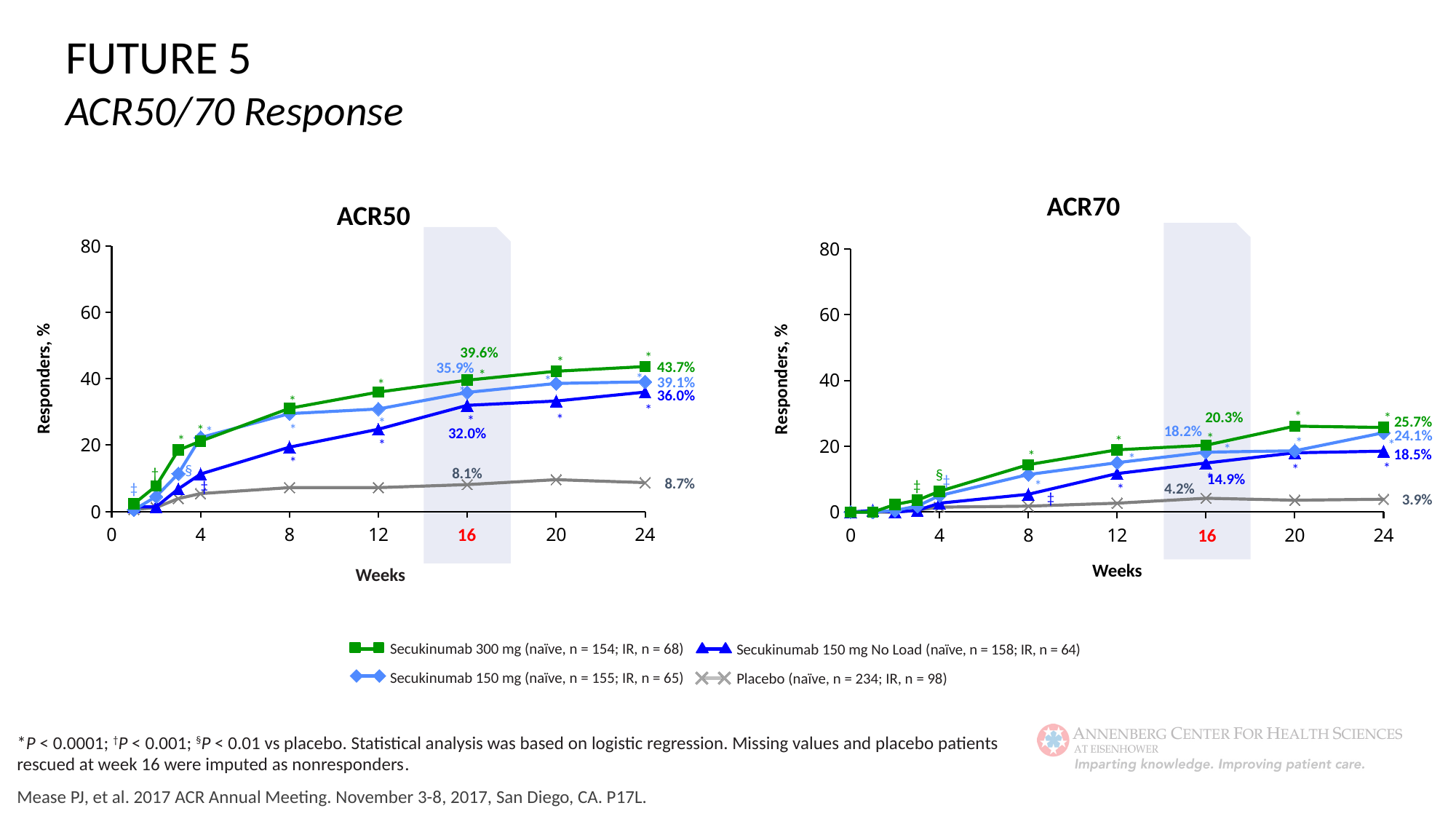
What kind of chart is the ACR70 chart? Line chart In the ACR50 chart, what is the response rate for Secukinumab 300 mg at week 24? 43.7% In the ACR70 chart, what is the difference between the Secukinumab 300 mg and Secukinumab 150 mg response rates at week 16? 2.1% In the ACR70 chart, what is the response rate for Secukinumab 150 mg No Load at week 16? 14.9% In the ACR50 chart, what is the difference between the Secukinumab 300 mg and Placebo response rates at week 24? 35.0% In the ACR50 chart, is the Secukinumab 150 mg No Load response rate at week 16 greater or less than 40? less In the ACR50 chart, what is the response rate for Placebo at week 16? 8.1% In the ACR50 chart, does the Secukinumab 300 mg response rate rise or fall from week 0 to week 24? Rise How many series does the legend list? 4 In the ACR50 chart, which series has the highest response rate at week 24? Secukinumab 300 mg In the ACR70 chart, what is the response rate for Secukinumab 150 mg at week 24? 24.1% In the ACR70 chart, which series has the lowest response rate at week 24? Placebo